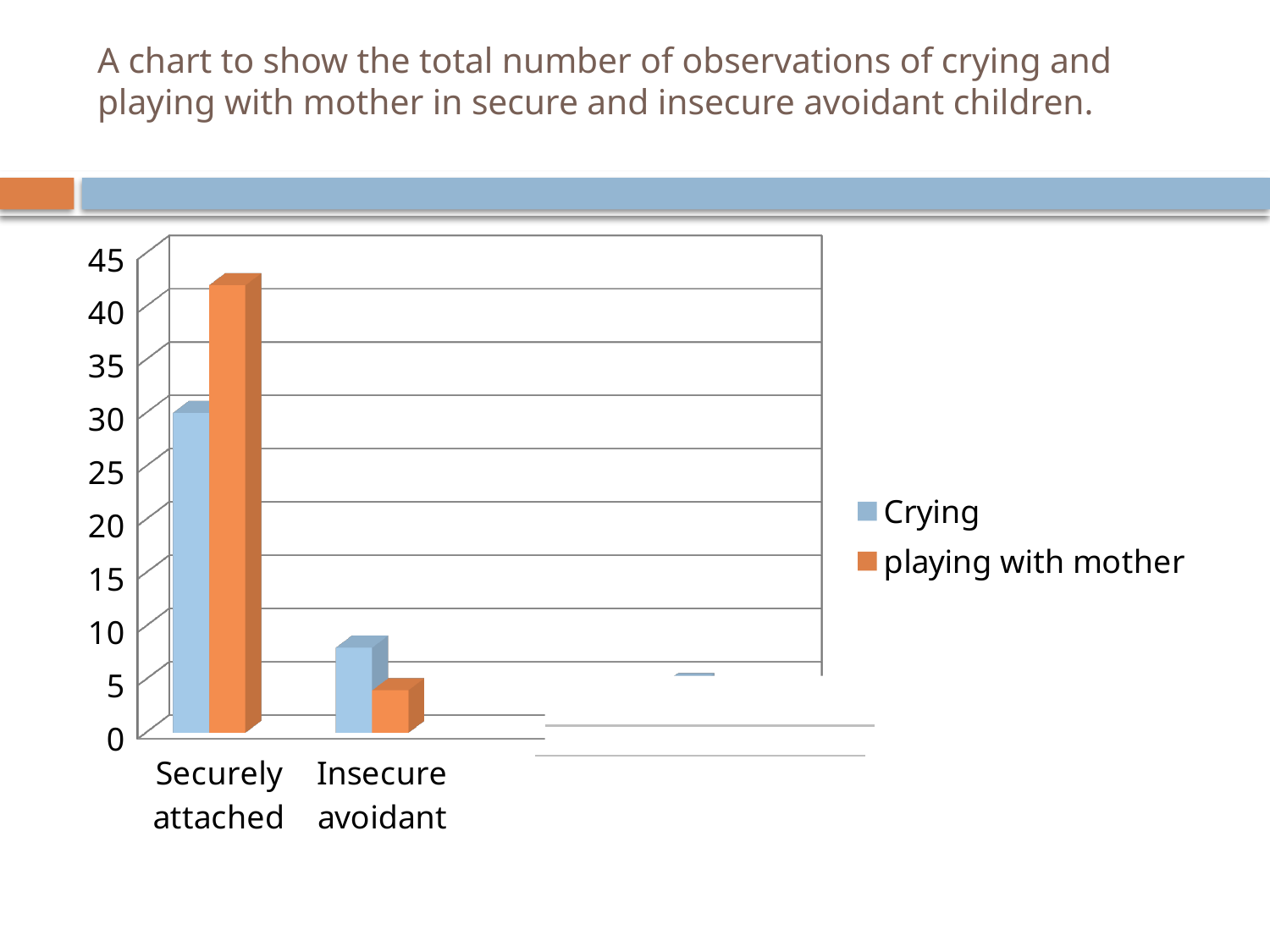
For Securely attached children, which is larger: Crying or playing with mother? playing with mother What is the highest value shown on the vertical axis? 45 Is the Crying value for Insecure avoidant greater or less than 10? less What kind of chart is shown on the slide? bar chart How many series does the legend list? 2 Is the playing with mother value for Securely attached greater or less than 40? greater Which category has the tallest bar overall? Securely attached (playing with mother) What are the two series named in the legend? Crying and playing with mother Which category has the lowest playing with mother value? Insecure avoidant Is the Crying value for Securely attached greater or less than 25? greater For Insecure avoidant children, which is larger: Crying or playing with mother? Crying